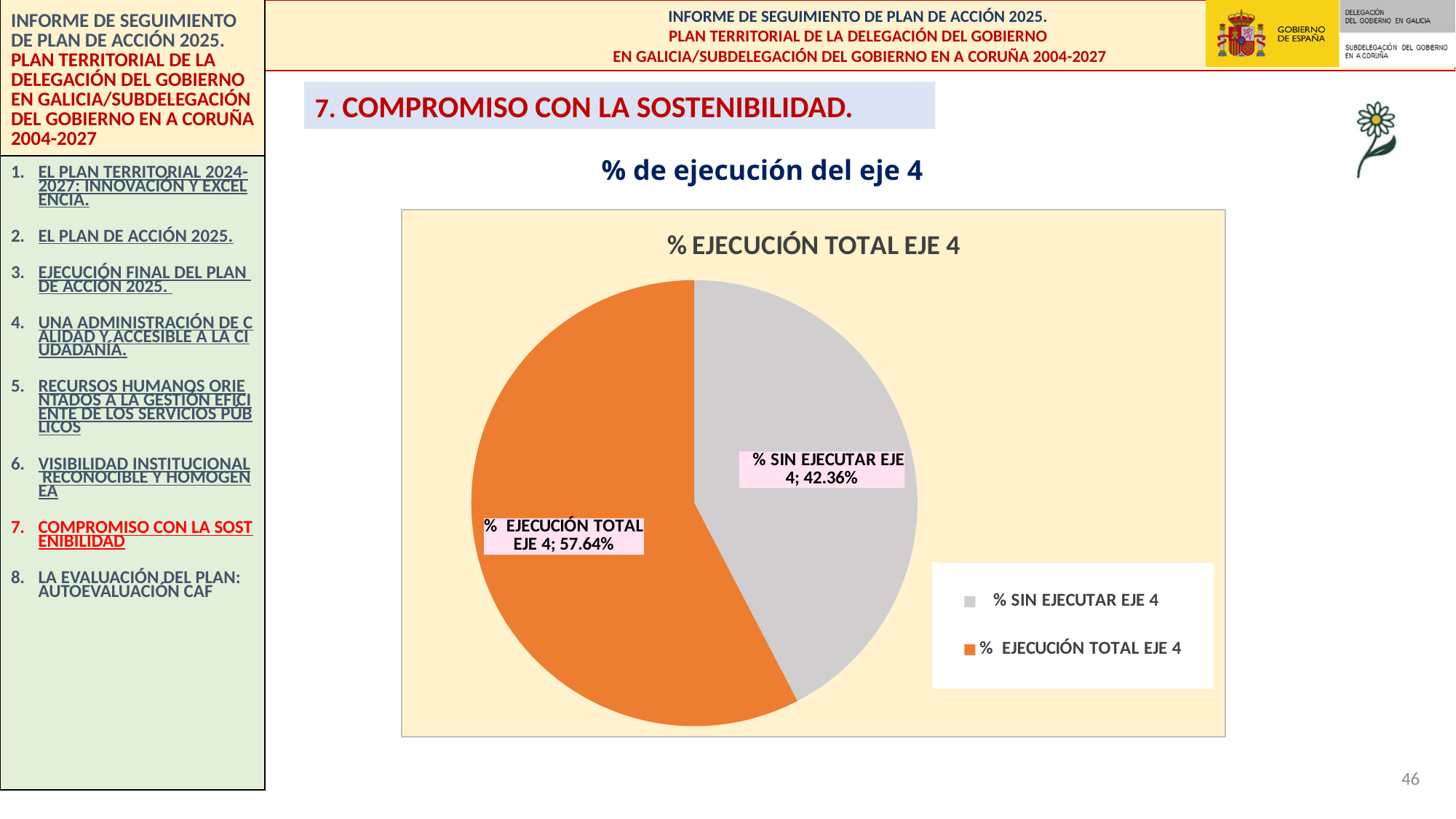
How many entries does the legend list? 2 Which is larger, % SIN EJECUTAR EJE 4 or % EJECUCIÓN TOTAL EJE 4? % EJECUCIÓN TOTAL EJE 4 What kind of chart is shown on the slide? pie chart What is the value shown for % SIN EJECUTAR EJE 4? 42.36% What is the difference between the % EJECUCIÓN TOTAL EJE 4 slice and the % SIN EJECUTAR EJE 4 slice? 15.28% What share of the pie does % SIN EJECUTAR EJE 4 represent? 42.36% What colour is the % EJECUCIÓN TOTAL EJE 4 slice? orange Which slice is the largest in the pie chart? % EJECUCIÓN TOTAL EJE 4 How many slices does the pie chart have? 2 Which slice is the smallest in the pie chart? % SIN EJECUTAR EJE 4 What is the title of the chart? % EJECUCIÓN TOTAL EJE 4 What is the value shown for % EJECUCIÓN TOTAL EJE 4? 57.64%